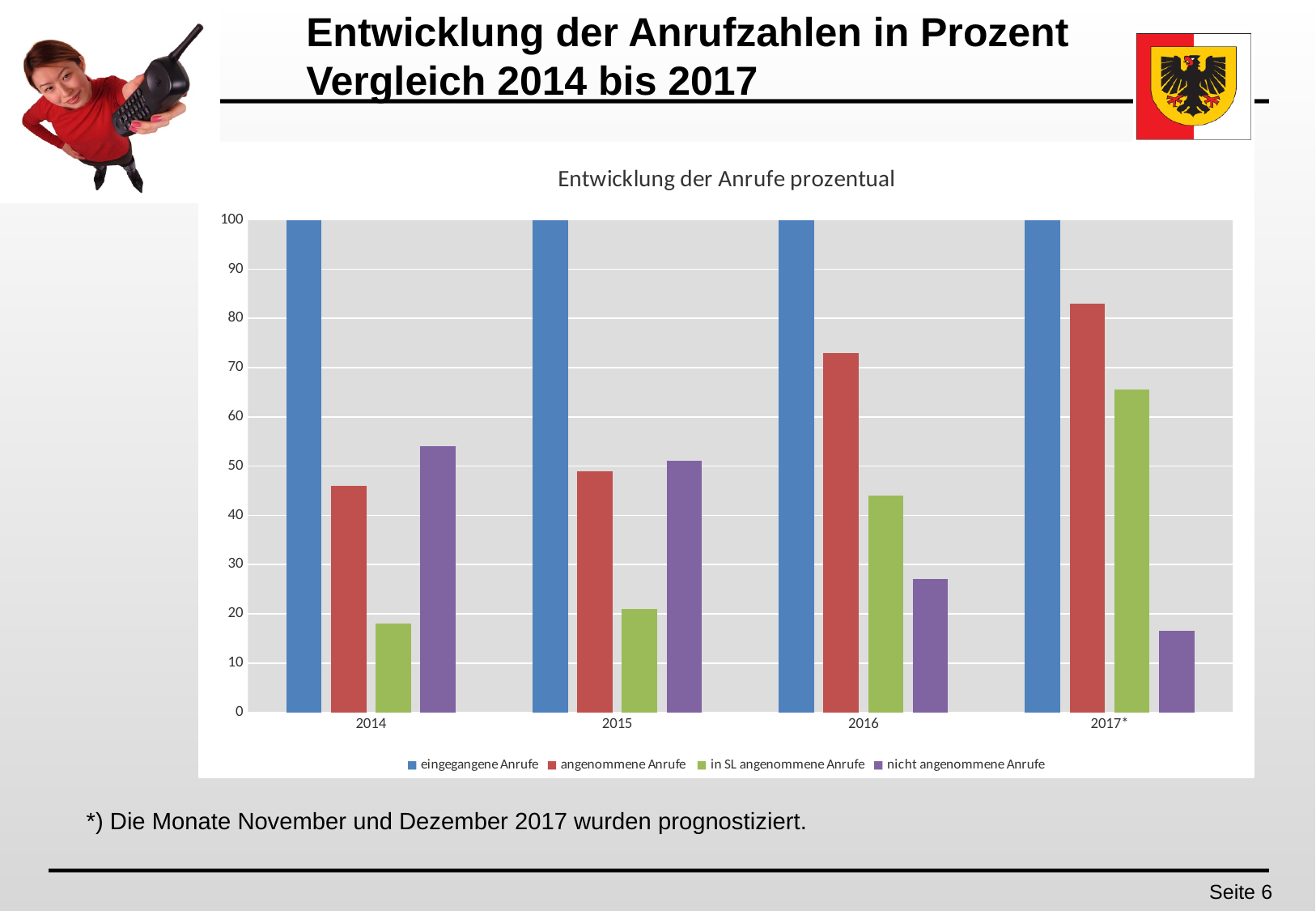
Is the value for in SL angenommene Anrufe in 2014 greater or less than 20? less In which year is the value for angenommene Anrufe highest? 2017* What is the value for eingegangene Anrufe in 2014? 100 Is the value for angenommene Anrufe in 2017* greater or less than 80? greater How many series does the legend list? 4 What kind of chart is shown on the slide? bar chart How many year categories are shown on the x axis? 4 Is the value for angenommene Anrufe in 2016 greater or less than 70? greater In which year is the value for nicht angenommene Anrufe lowest? 2017* Do the values for nicht angenommene Anrufe rise or fall from 2014 to 2017*? fall In 2014, which is larger: angenommene Anrufe or nicht angenommene Anrufe? nicht angenommene Anrufe